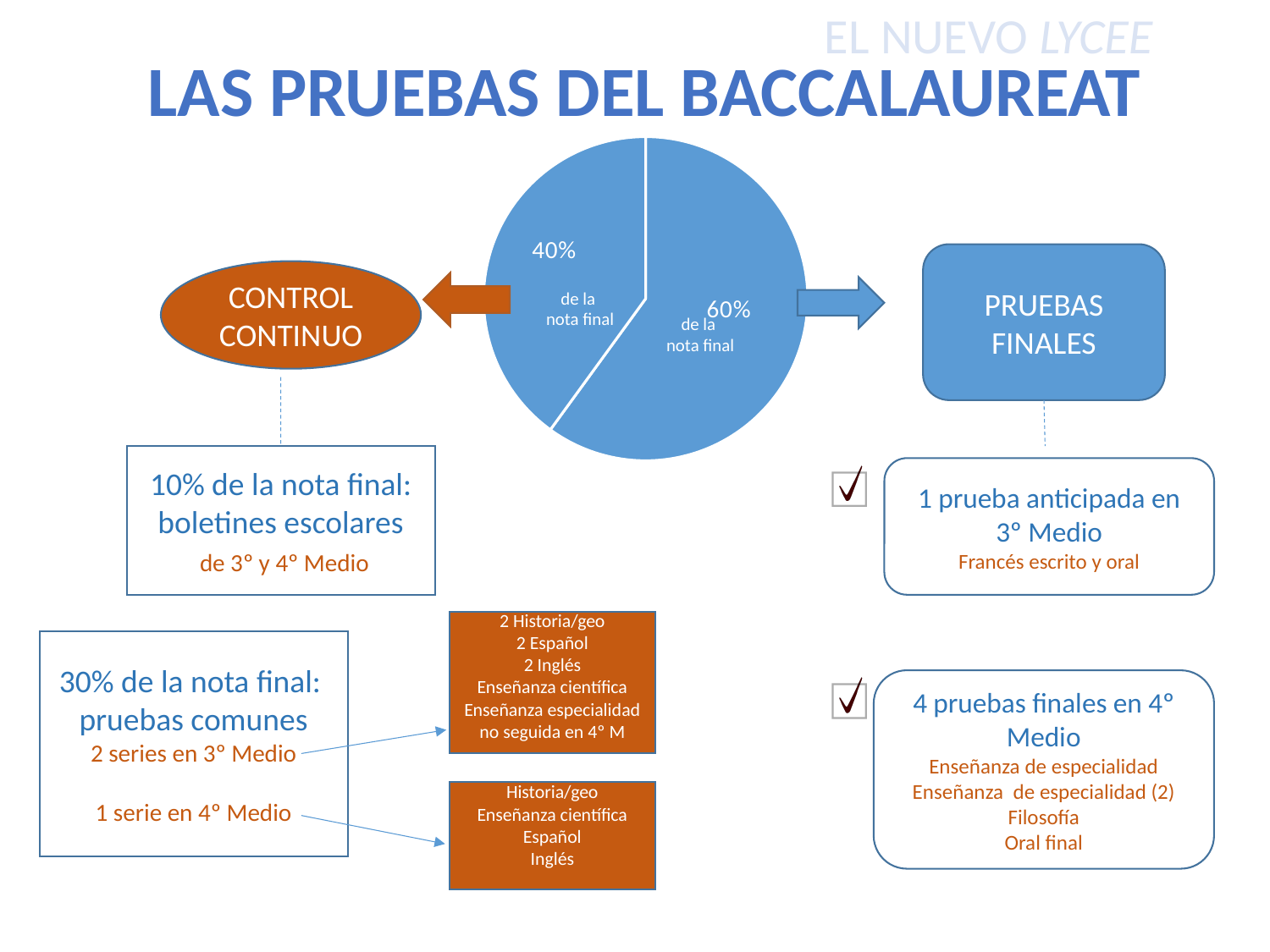
What kind of chart is shown in the centre of the slide? pie chart Which slice of the pie chart is the smallest? 40% Is the left-hand slice of the pie chart larger or smaller than the right-hand slice? smaller What do the two slices of the pie chart add up to? 100% How many slices does the pie chart have? 2 What percentage is shown on the smaller slice of the pie chart? 40% Which slice of the pie chart is the largest, the 40% slice or the 60% slice? 60% What is the value printed on the left-hand slice of the pie chart? 40% What is the value printed on the right-hand slice of the pie chart? 60% What percentage is shown on the larger slice of the pie chart? 60% What is the difference between the two slices of the pie chart? 20% What text accompanies each percentage label on the pie chart? de la nota final